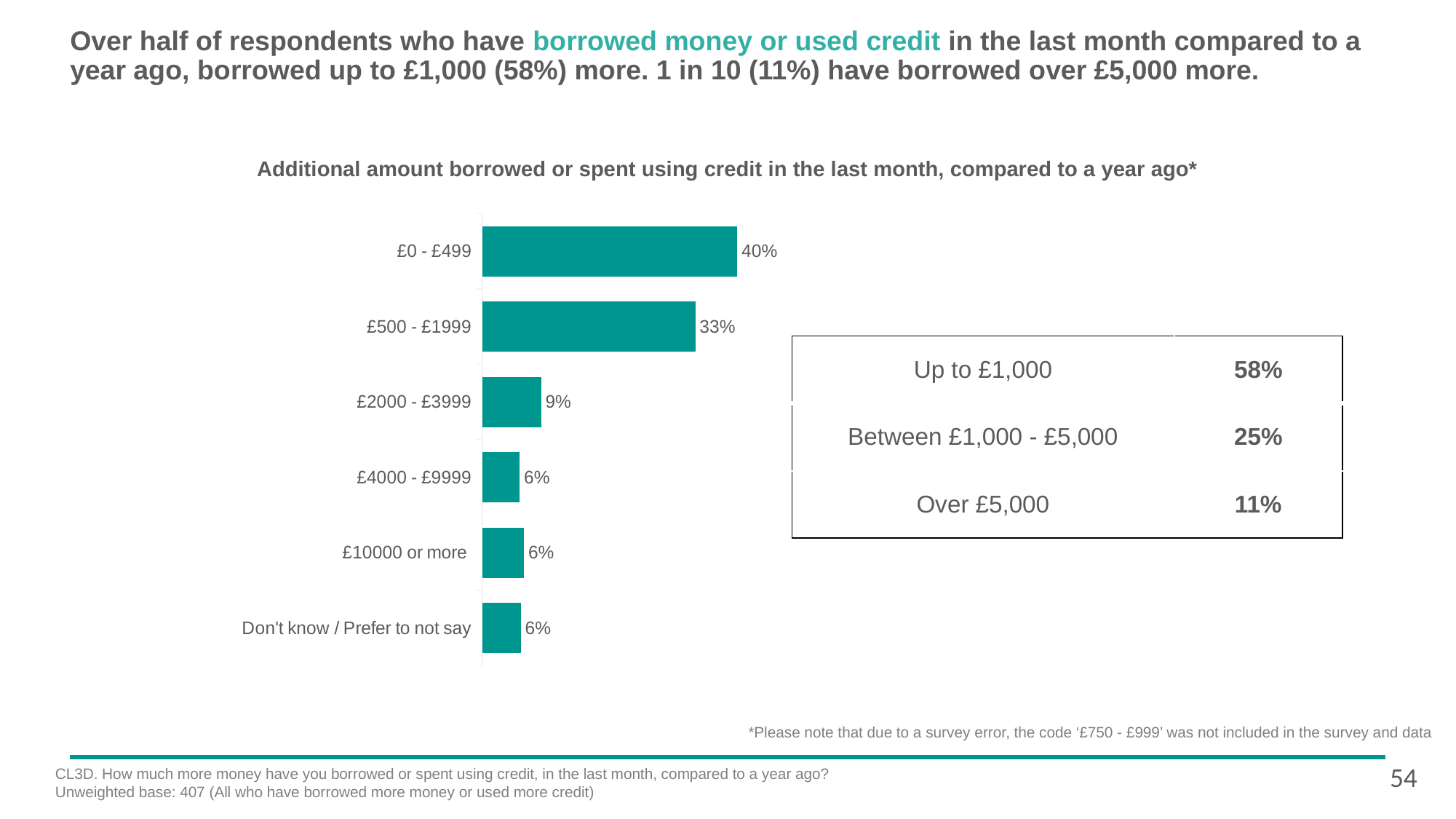
What percentage of respondents borrowed £0 - £499 more? 40% What is the value for the £500 - £1999 category? 33% What is the value for the £10000 or more category? 6% What percentage of respondents borrowed £2000 - £3999 more? 9% Which category has the highest value? £0 - £499 What is the title of the chart? Additional amount borrowed or spent using credit in the last month, compared to a year ago* What is the difference between the £500 - £1999 and £2000 - £3999 values? 24% What colour are the bars in the chart? Teal Which is larger, the value for £2000 - £3999 or the value for £4000 - £9999? £2000 - £3999 How many categories are shown in the bar chart? 6 What is the difference between the £0 - £499 and £500 - £1999 values? 7% What type of chart is shown on the slide? Bar chart